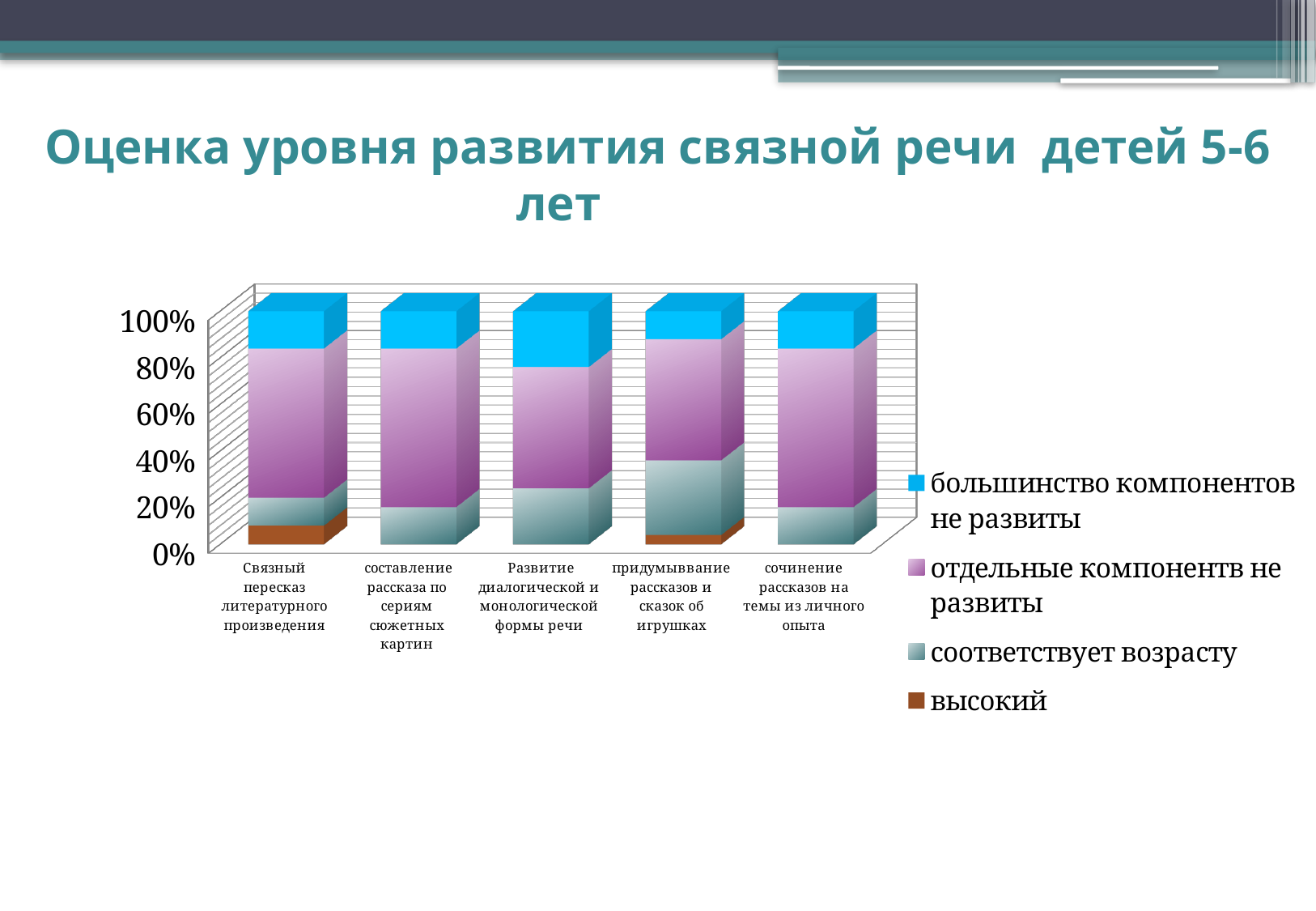
What is the title of the slide containing the chart? Оценка уровня развития связной речи детей 5-6 лет Which is larger: the 'отдельные компонентв не развиты' segment for 'составление рассказа по сериям сюжетных картин' or for 'Развитие диалогической и монологической формы речи'? составление рассказа по сериям сюжетных картин Is the 'соответствует возрасту' value for 'придумыввание рассказов и сказок об игрушках' greater or less than 20%? greater How many categories are shown along the x axis of the chart? 5 Is the 'большинство компонентов не развиты' value for 'придумыввание рассказов и сказок об игрушках' greater or less than 20%? less What kind of chart is shown on the slide? Stacked bar chart Is the 'отдельные компонентв не развиты' value for 'составление рассказа по сериям сюжетных картин' greater or less than 60%? greater How many categories include a 'высокий' segment? 2 Which category has the largest 'соответствует возрасту' segment? придумыввание рассказов и сказок об игрушках How many series does the chart legend list? 4 Which category has the largest 'большинство компонентов не развиты' segment? Развитие диалогической и монологической формы речи Which legend entry is shown in brown? высокий